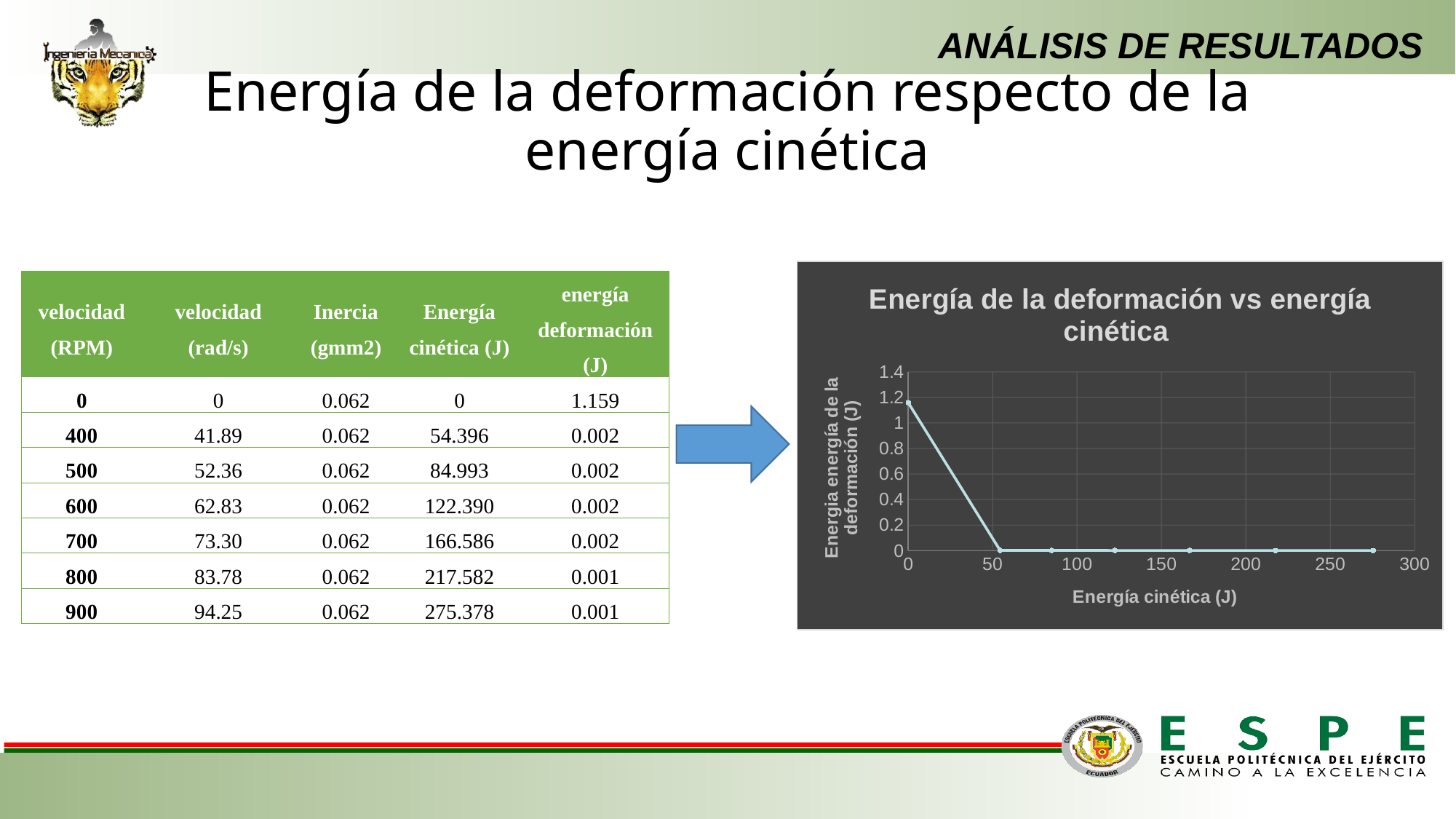
Is the value of the point near energía cinética 150 greater or less than 0.4? less At which energía cinética value does the chart reach its highest point? 0 What is the highest tick value shown on the y axis? 1.4 How many data points are plotted on the chart? 7 Do the values rise or fall as energía cinética increases from 0 to 50? fall What is the label of the x axis of the chart? Energía cinética (J) What is the title of the chart? Energía de la deformación vs energía cinética What kind of chart is shown on the slide? line chart Is the value of the first point (at energía cinética 0) greater or less than 1.4? less Which point has the larger value: the one at energía cinética 0 or the one near 50? the one at 0 Is the value of the first point (at energía cinética 0) greater or less than 1? greater